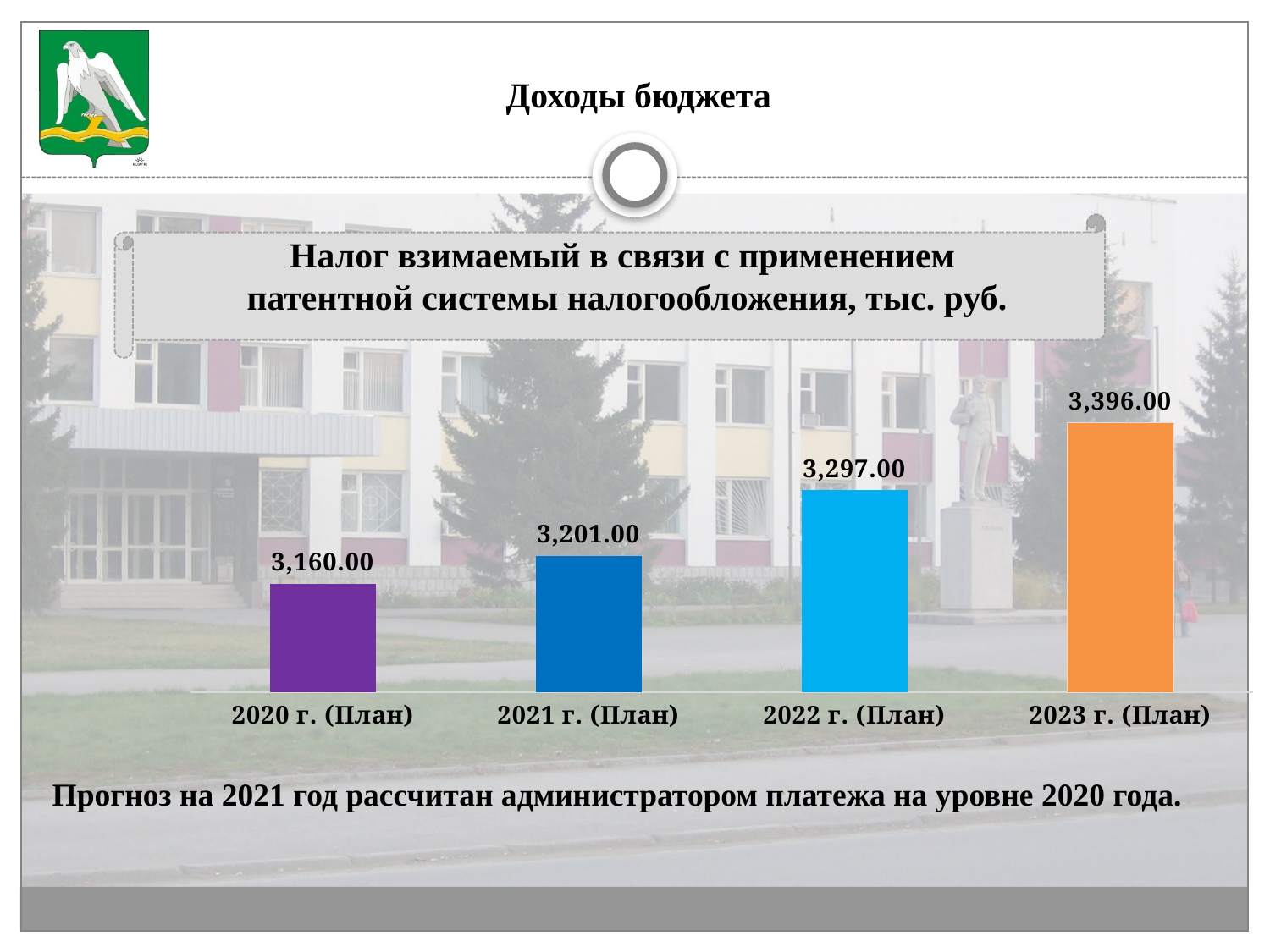
Which year has the highest value? 2023 г. (План) What is the difference between the values for 2022 г. (План) and 2021 г. (План)? 96.00 Which year has the lowest value? 2020 г. (План) What is the value for 2020 г. (План)? 3,160.00 What is the value for 2021 г. (План)? 3,201.00 What is the value for 2022 г. (План)? 3,297.00 What is the value for 2023 г. (План)? 3,396.00 Do the values rise or fall from 2020 to 2023? Rise What kind of chart is shown on the slide? Bar chart Which is larger, the value for 2021 г. (План) or 2022 г. (План)? 2022 г. (План) How many categories are shown in the chart? 4 What is the difference between the values for 2023 г. (План) and 2020 г. (План)? 236.00